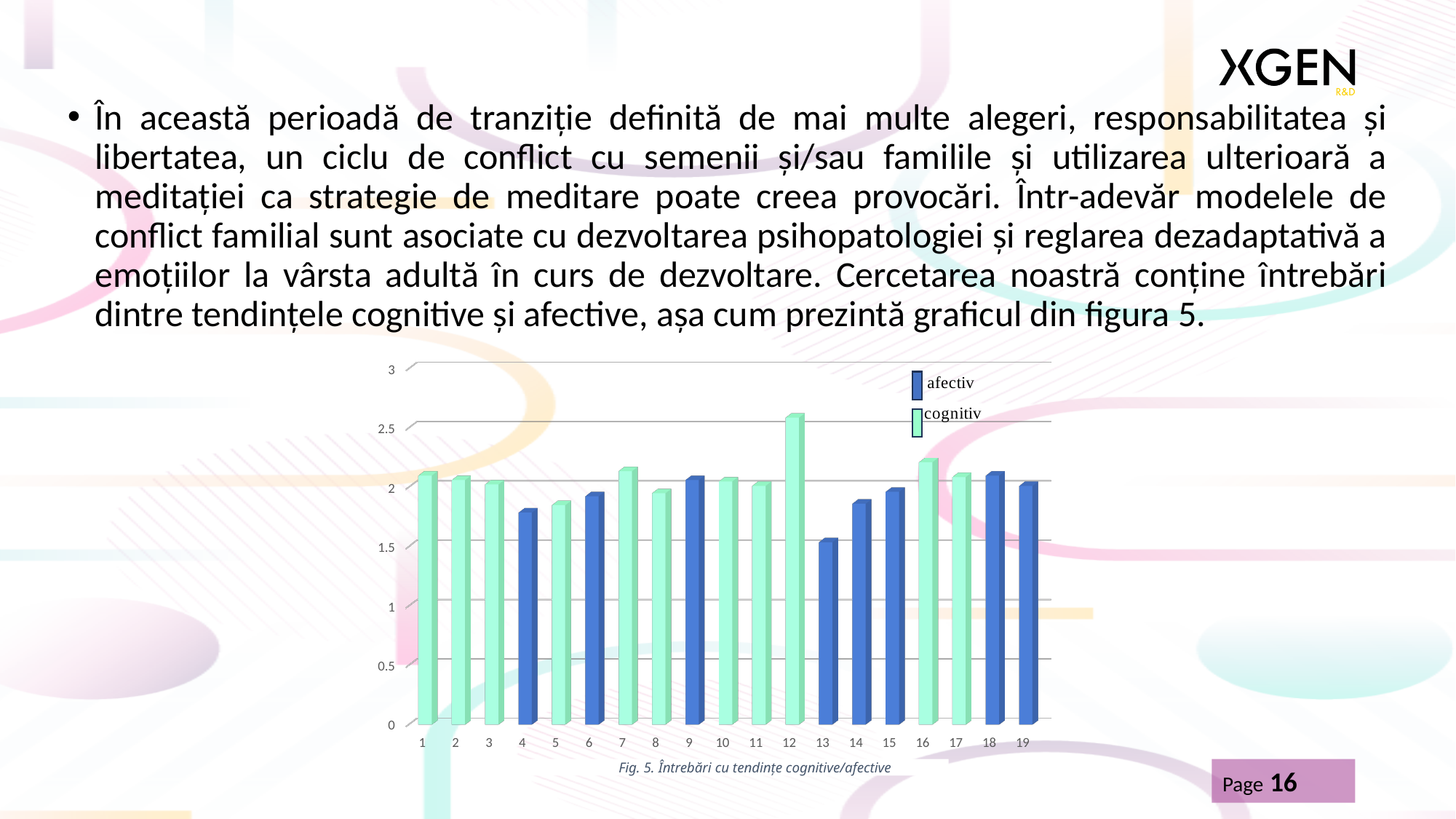
Which series is drawn in blue? afectiv What kind of chart is shown on the slide? bar chart Which category has the lowest bar? 13 How many series does the legend list? 2 Which category has the highest bar? 12 Is the value for category 4 greater or less than 2? less Is the value for category 13 greater or less than 2? less Which is larger, the value for category 12 or the value for category 13? 12 What is the caption of the figure below the chart? Fig. 5. Întrebări cu tendințe cognitive/afective How many categories are shown along the x axis? 19 Is the value for category 16 greater or less than 2? greater